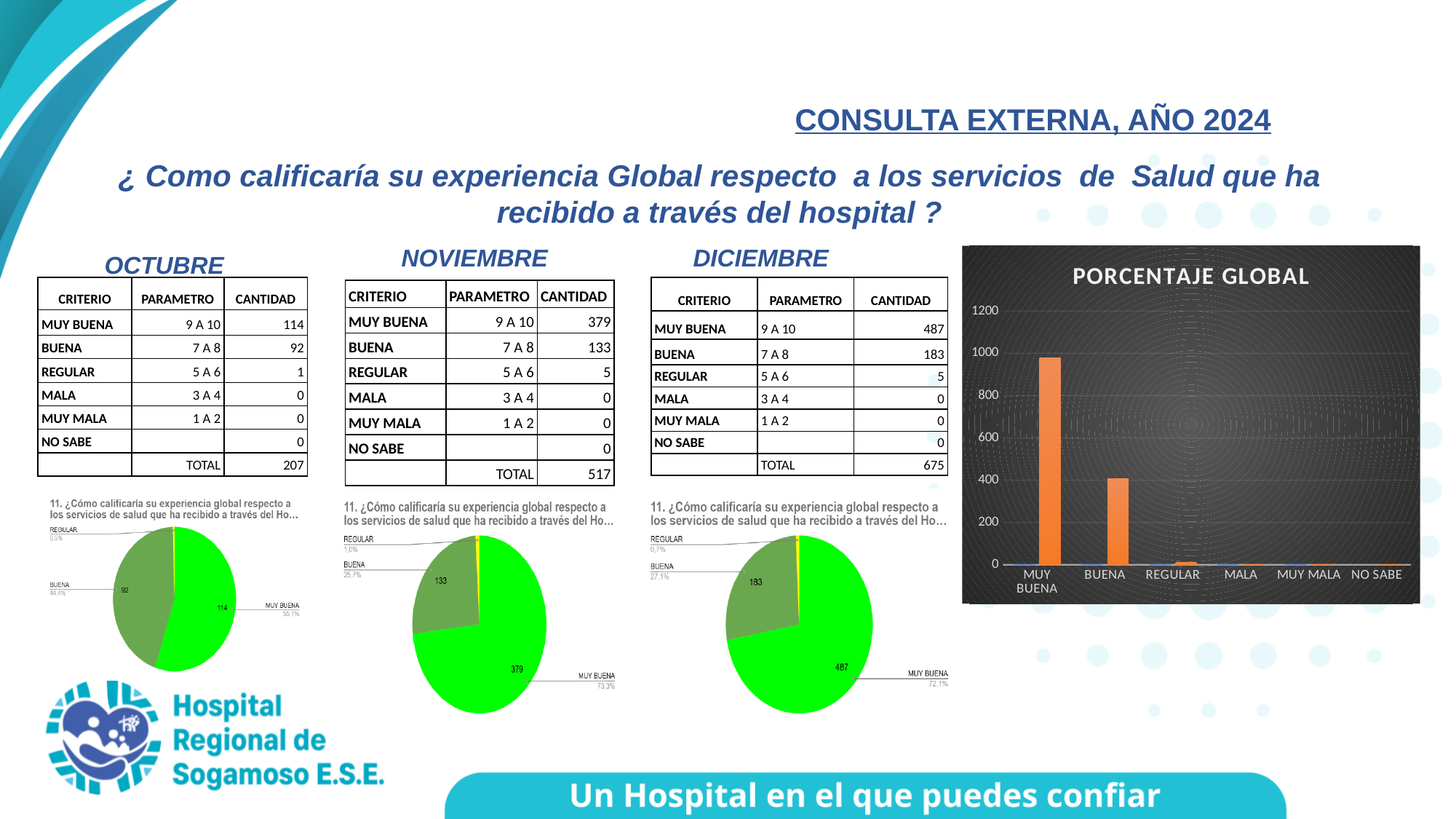
What is the title of the bar chart on the right of the slide? PORCENTAJE GLOBAL In the PORCENTAJE GLOBAL bar chart, is the value for BUENA greater or less than 600? less In the NOVIEMBRE pie chart, what percentage share does MUY BUENA have? 73,3% In the OCTUBRE pie chart, what percentage share does BUENA have? 44,4% In the PORCENTAJE GLOBAL bar chart, is the value for MUY BUENA greater or less than 800? greater In the PORCENTAJE GLOBAL bar chart, how many categories are shown on the x axis? 6 What kind of chart is the PORCENTAJE GLOBAL chart? bar chart In the NOVIEMBRE pie chart, what is the difference between the MUY BUENA value and the BUENA value? 246 In the DICIEMBRE pie chart, what value is shown for BUENA? 183 In the OCTUBRE pie chart, what value is shown for MUY BUENA? 114 In the PORCENTAJE GLOBAL bar chart, which category has the highest bar? MUY BUENA In the PORCENTAJE GLOBAL bar chart, which is larger, BUENA or REGULAR? BUENA